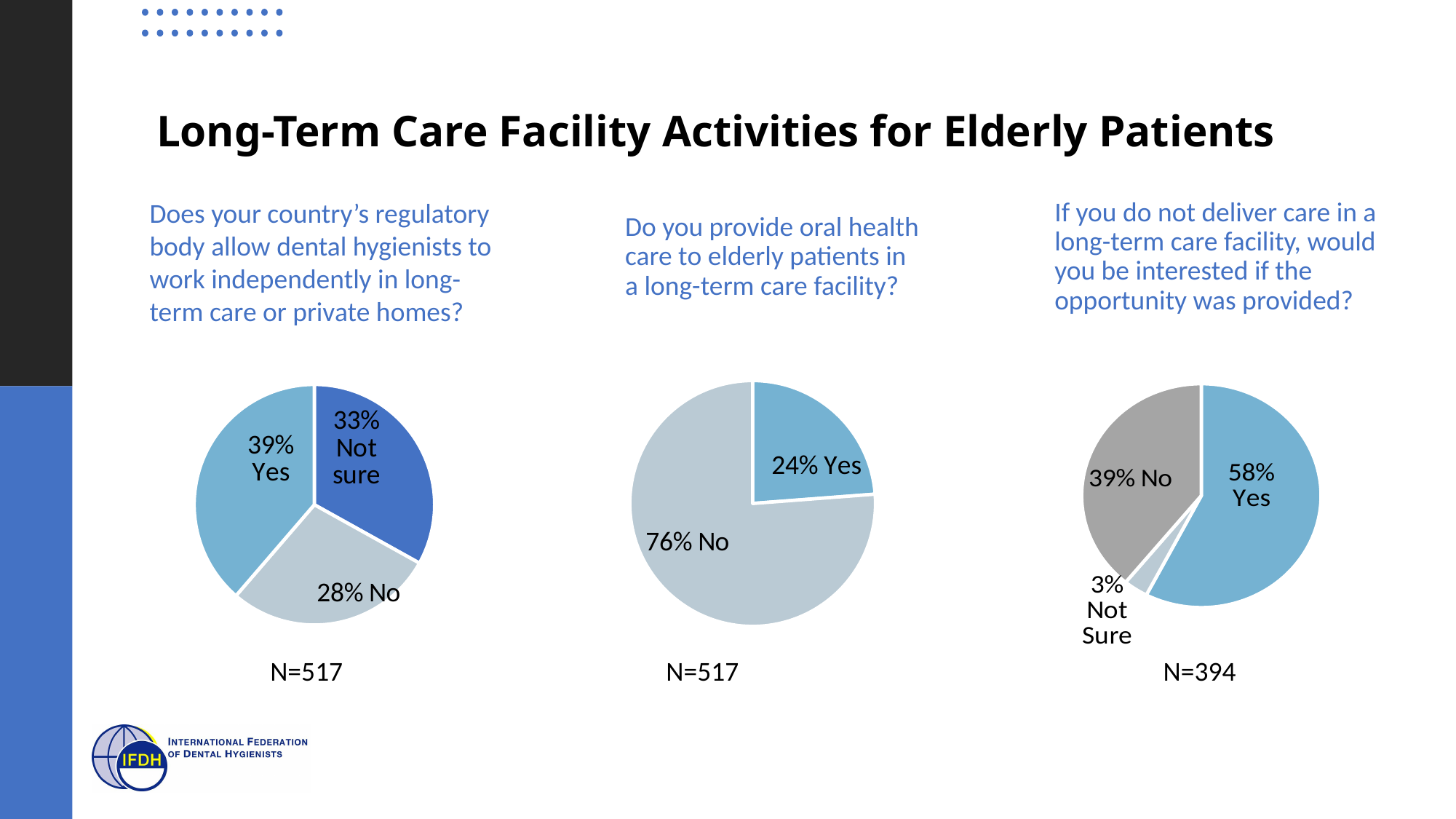
In the left pie chart (regulatory body allowing dental hygienists to work independently), which response has the smallest share? No In the middle pie chart (providing oral health care in a long-term care facility), what share of respondents answered No? 76% In the right pie chart (interest if the opportunity was provided), what share of respondents answered Yes? 58% In the middle pie chart (providing oral health care in a long-term care facility), what is the difference between the No and Yes shares? 52% In the right pie chart (interest if the opportunity was provided), what share of respondents answered Not Sure? 3% What type of chart is used for the three charts on the slide? Pie chart In the right pie chart (interest if the opportunity was provided), which response has the largest share? Yes In the left pie chart (regulatory body allowing dental hygienists to work independently), how many slices does the pie have? 3 What is the sample size (N) shown under the right pie chart (interest if the opportunity was provided)? N=394 In the left pie chart (regulatory body allowing dental hygienists to work independently), what share of respondents answered Not sure? 33% In the middle pie chart (providing oral health care in a long-term care facility), which response has the larger share, Yes or No? No In the left pie chart (regulatory body allowing dental hygienists to work independently), what share of respondents answered Yes? 39%